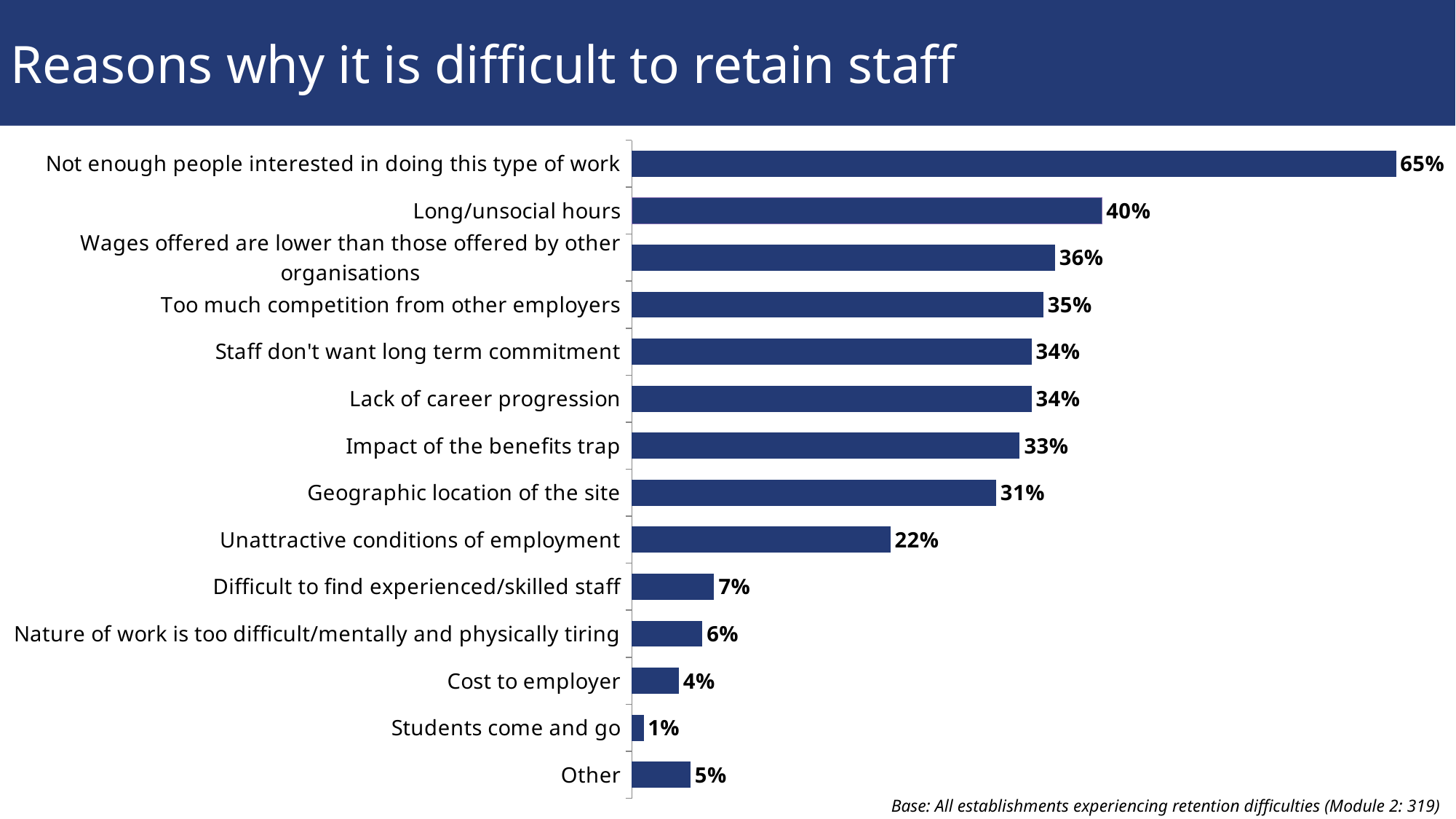
Which reason has the lowest percentage? Students come and go Which reason has the highest percentage? Not enough people interested in doing this type of work What percentage is shown for 'Long/unsocial hours'? 40% Which is larger: the value for 'Impact of the benefits trap' or the value for 'Unattractive conditions of employment'? Impact of the benefits trap What is the value for 'Geographic location of the site'? 31% How many reasons (categories) are plotted in the chart? 14 What is the title of the slide? Reasons why it is difficult to retain staff What percentage is shown for 'Cost to employer'? 4% Which is larger: 'Other' or 'Students come and go'? Other What is the difference between the values for 'Not enough people interested in doing this type of work' and 'Long/unsocial hours'? 25% What kind of chart is shown on the slide? Bar chart What is the difference between 'Unattractive conditions of employment' and 'Difficult to find experienced/skilled staff'? 15%